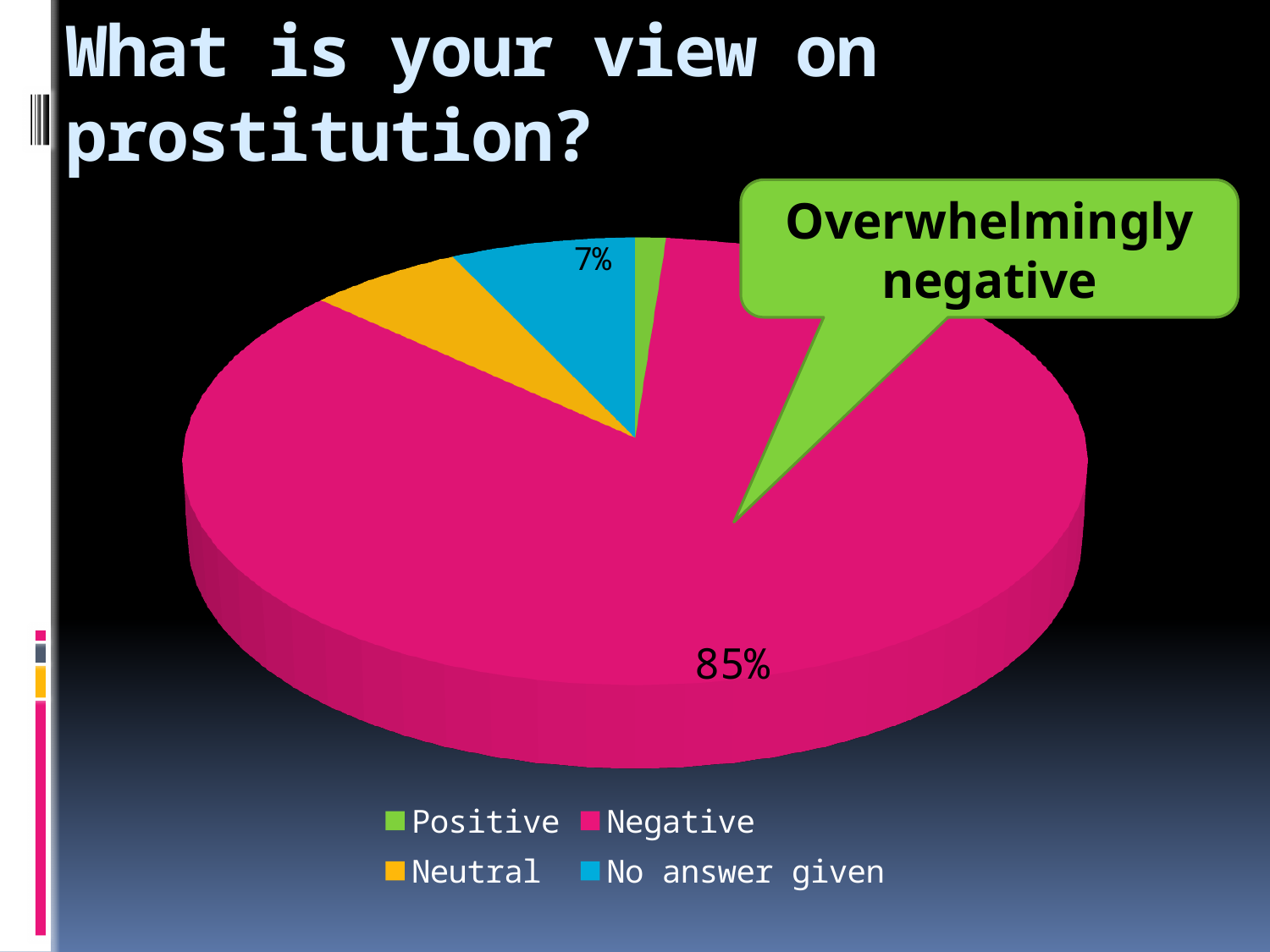
How many percentage points larger is the Negative share than the No answer given share? 78 percentage points What question does the chart title ask? What is your view on prostitution? Which response category has the largest share of the pie? Negative Which is larger, the share for Negative or the share for No answer given? Negative How many response categories does the pie chart show? 4 What percentage of respondents gave a Negative view on prostitution? 85% Which is larger, the share for Neutral or the share for Positive? Neutral What type of chart is shown on the slide? Pie chart Which response category has the smallest share of the pie? Positive What percentage of respondents gave no answer? 7% What does the green callout pointing at the pie say? Overwhelmingly negative